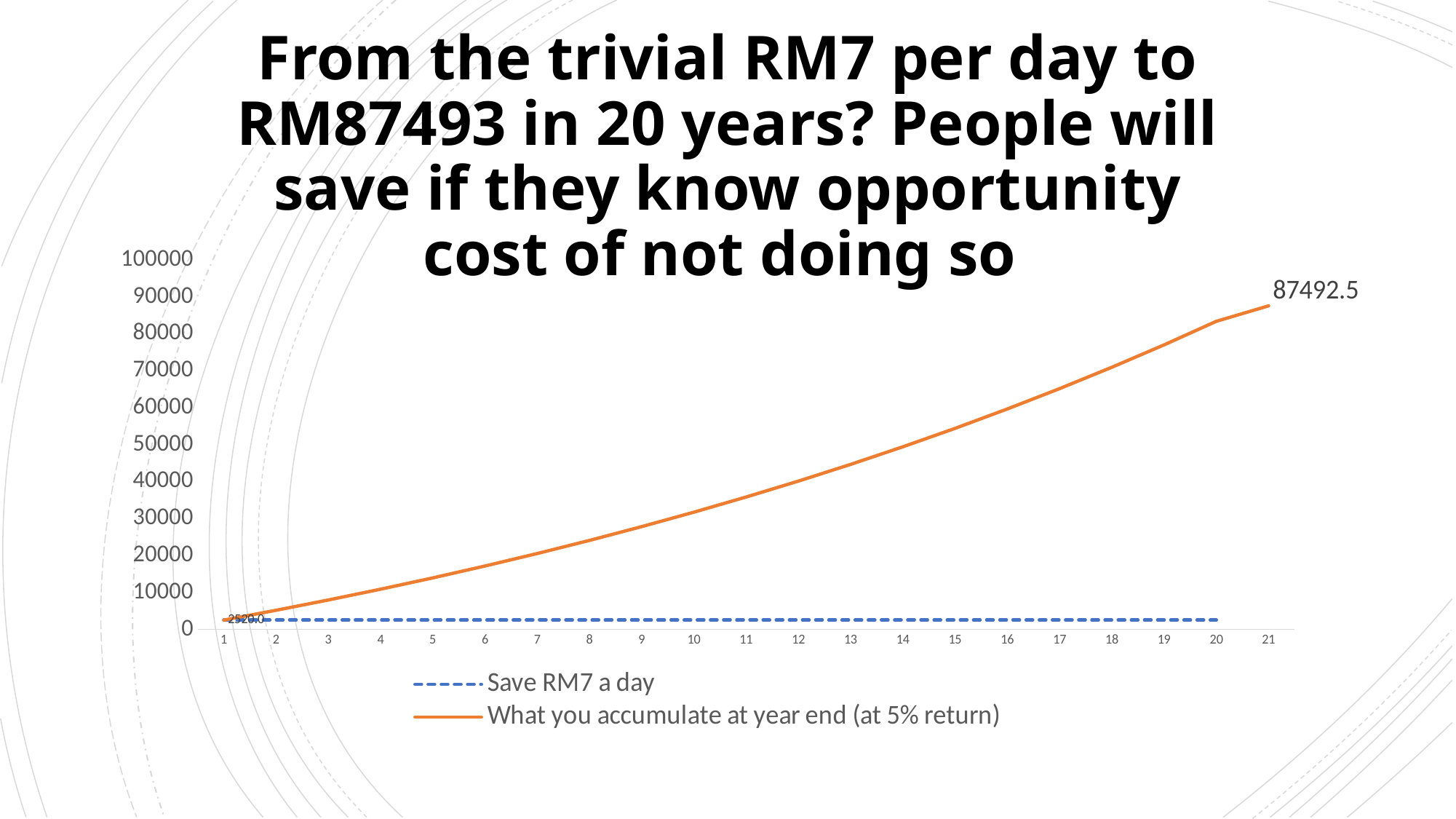
Which series reaches the highest value on the chart? What you accumulate at year end (at 5% return) How many x-axis labels are shown on the chart? 21 Which series is drawn as a dashed blue line? Save RM7 a day What kind of chart is shown on the slide? line chart How many series does the legend list? 2 At x = 15, which series has the higher value: 'Save RM7 a day' or 'What you accumulate at year end (at 5% return)'? What you accumulate at year end (at 5% return) Is the value of 'What you accumulate at year end (at 5% return)' at x = 16 greater or less than 50000? greater What is the labelled value of the 'What you accumulate at year end (at 5% return)' series at x = 21? 87492.5 What is the highest tick value shown on the y axis? 100000 Is the value of 'What you accumulate at year end (at 5% return)' at x = 5 greater or less than 20000? less Is the value of 'Save RM7 a day' at x = 10 greater or less than 10000? less Does the 'What you accumulate at year end (at 5% return)' series rise or fall along the x axis? rise